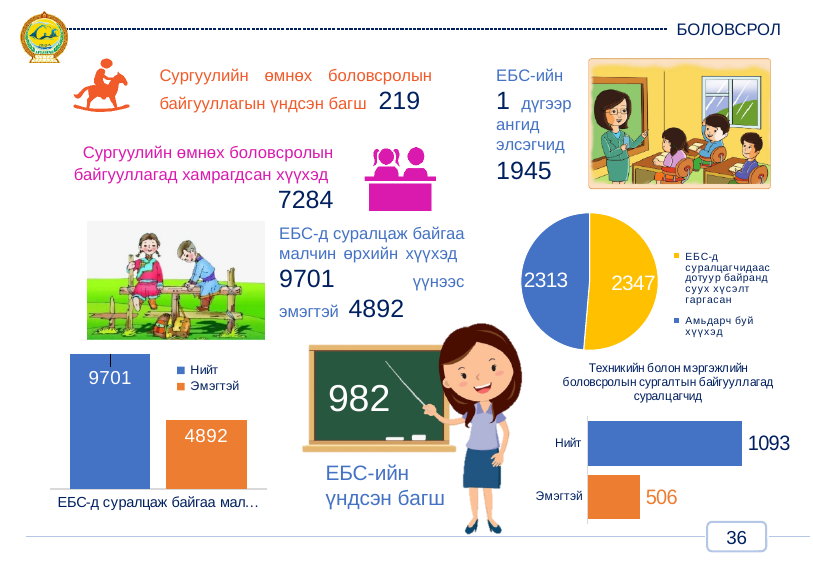
In the chart titled 'Техникийн болон мэргэжлийн боловсролын сургалтын байгууллагад суралцагчид', what is the value for Эмэгтэй? 506 In the chart titled 'Техникийн болон мэргэжлийн боловсролын сургалтын байгууллагад суралцагчид', what is the difference between Нийт and Эмэгтэй? 587 In the pie chart on the right, what is the value of the blue slice labelled 'Амьдарч буй хүүхэд'? 2313 What kind of chart is the bottom-left chart? bar chart In the bottom-left bar chart, what is the value for Эмэгтэй? 4892 In the pie chart on the right, what is the value of the yellow slice labelled 'ЕБС-д суралцагчидаас дотуур байранд суух хүсэлт гаргасан'? 2347 In the bottom-left bar chart, how many series does the legend list? 2 In the bottom-left bar chart, what is the difference between the Нийт and Эмэгтэй values? 4809 In the pie chart on the right, what is the total of the two slices? 4660 In the pie chart on the right, how many slices are there? 2 In the chart titled 'Техникийн болон мэргэжлийн боловсролын сургалтын байгууллагад суралцагчид', what is the value for Нийт? 1093 In the bottom-left bar chart, what is the value for Нийт? 9701